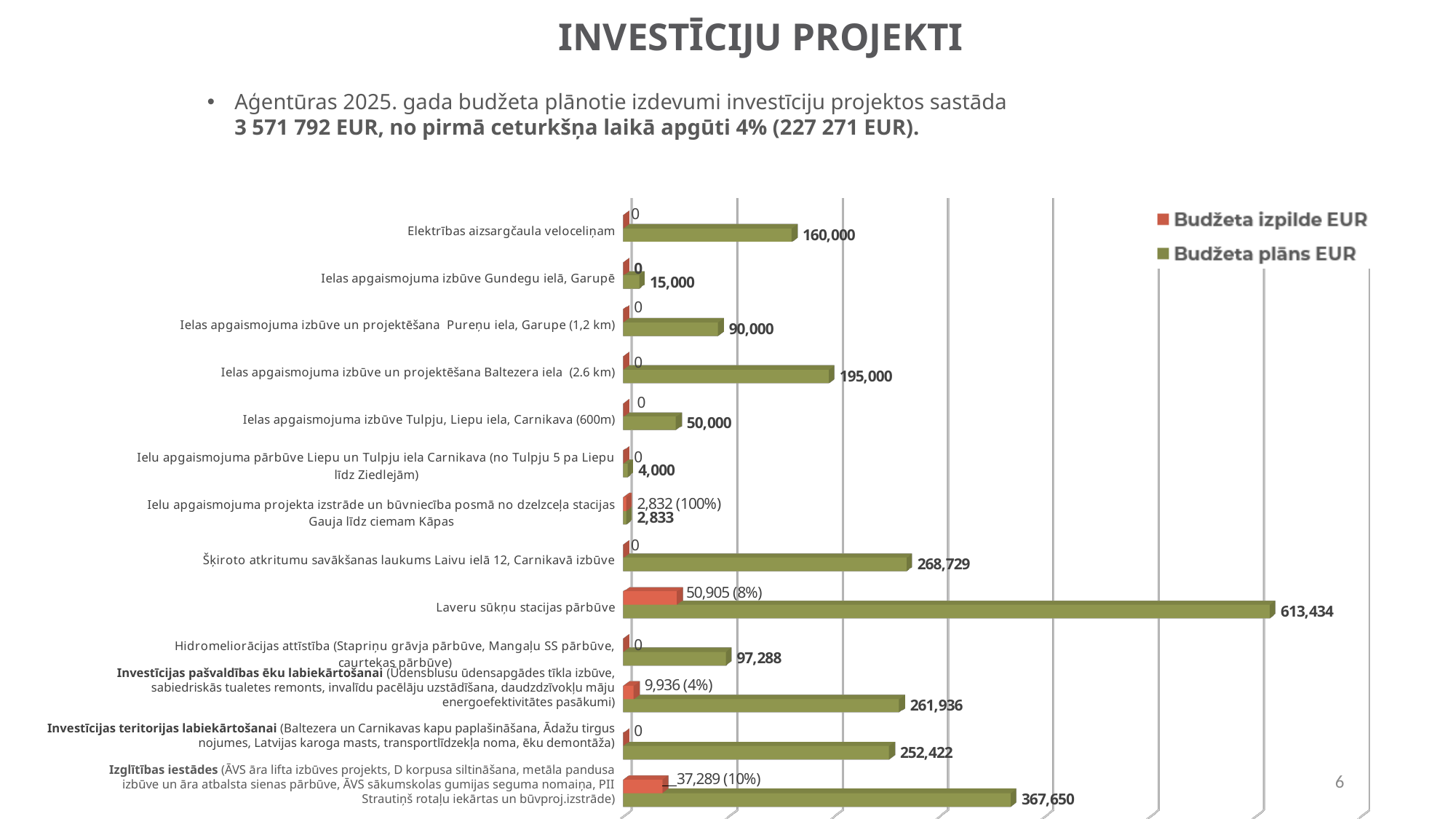
Which colour represents the Budžeta plāns EUR series in the chart? green How many series does the chart legend list? 2 How many categories (projects) are shown in the chart? 13 What is the Budžeta izpilde EUR value for Laveru sūkņu stacijas pārbūve? 50,905 (8%) Which category has the highest Budžeta plāns EUR value? Laveru sūkņu stacijas pārbūve Which has a larger Budžeta plāns EUR value: Ielas apgaismojuma izbūve un projektēšana Baltezera iela (2.6 km) or Ielas apgaismojuma izbūve un projektēšana Pureņu iela, Garupe (1,2 km)? Ielas apgaismojuma izbūve un projektēšana Baltezera iela (2.6 km) What is the Budžeta plāns EUR value for Elektrības aizsargčaula veloceliņam? 160,000 Which category has the lowest Budžeta plāns EUR value? Ielu apgaismojuma projekta izstrāde un būvniecība posmā no dzelzceļa stacijas Gauja līdz ciemam Kāpas What is the difference between the Budžeta plāns EUR values for Izglītības iestādes and Šķiroto atkritumu savākšanas laukums Laivu ielā 12, Carnikavā izbūve? 98,921 What is the Budžeta izpilde EUR value for Investīcijas pašvaldības ēku labiekārtošanai? 9,936 (4%) What kind of chart is shown on the slide? bar chart What is the Budžeta plāns EUR value for Laveru sūkņu stacijas pārbūve? 613,434